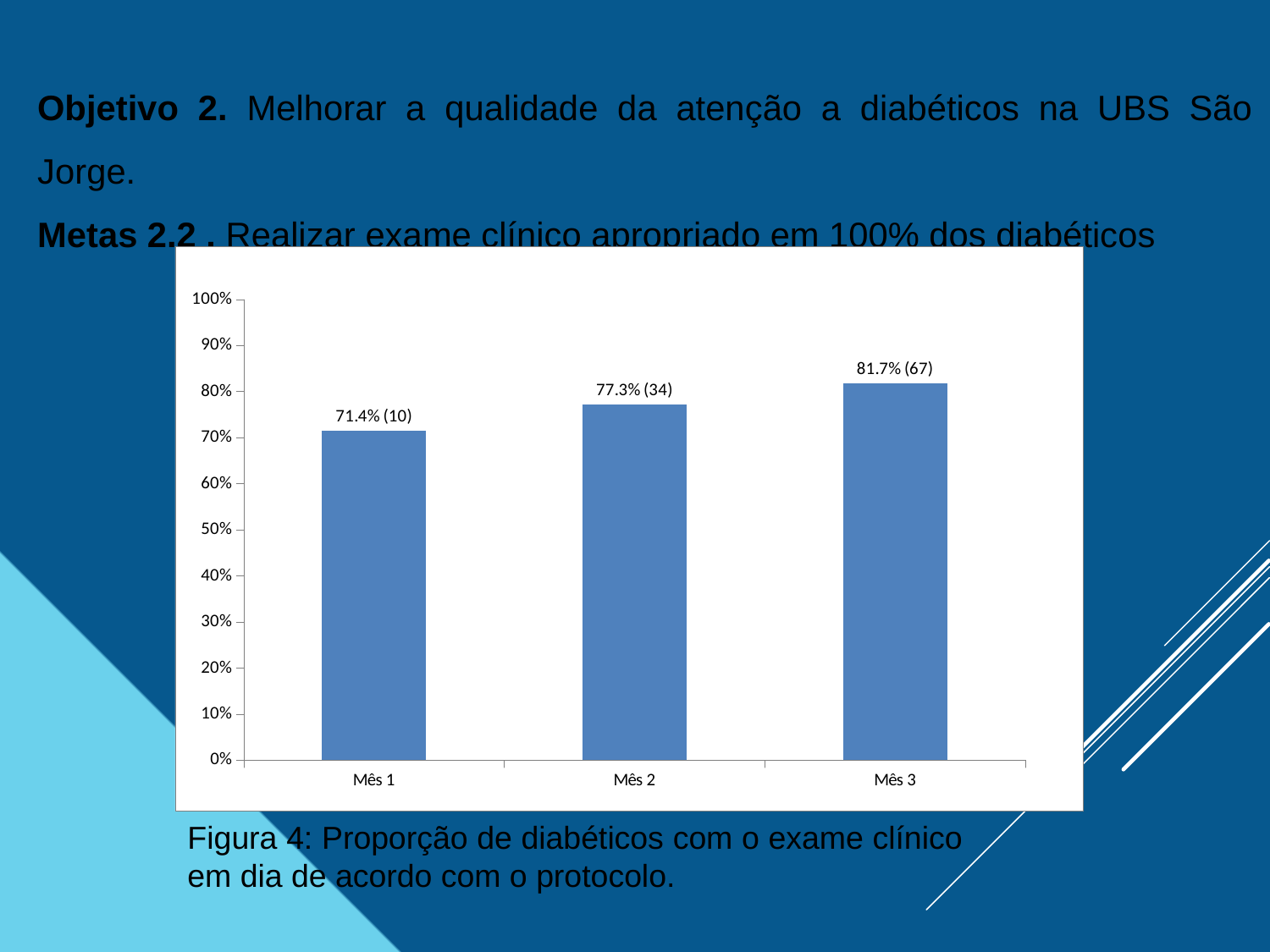
Which month has the highest proportion? Mês 3 Which is larger, the value for Mês 2 or the value for Mês 1? Mês 2 What is the value shown for Mês 1? 71.4% (10) Is the value for Mês 3 greater or less than 80%? greater What is the value shown for Mês 3? 81.7% (67) What is the figure caption below the chart? Figura 4: Proporção de diabéticos com o exame clínico em dia de acordo com o protocolo. What is the difference in percentage points between Mês 3 and Mês 1? 10.3 What kind of chart is shown on the slide? Bar chart What is the value shown for Mês 2? 77.3% (34) Which month has the lowest proportion? Mês 1 Do the values rise or fall from Mês 1 to Mês 3? Rise How many months are shown on the x axis? 3